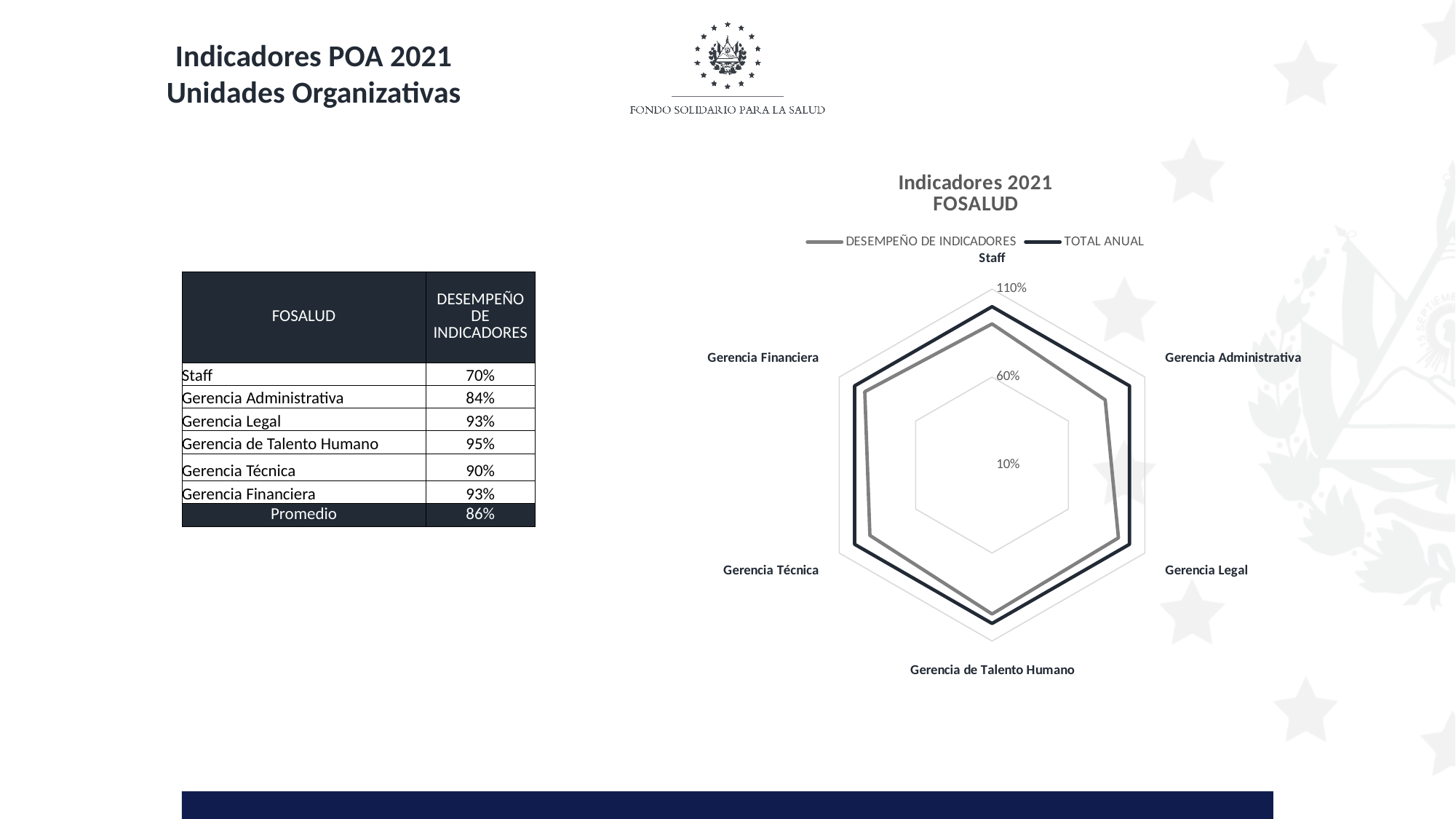
In the 'Indicadores 2021 FOSALUD' chart, is the TOTAL ANUAL value for Gerencia Legal greater or less than 110%? less What kind of chart is the 'Indicadores 2021 FOSALUD' chart? radar chart In the 'Indicadores 2021 FOSALUD' chart, is the DESEMPEÑO DE INDICADORES value for Staff greater or less than 60%? greater Which series in the 'Indicadores 2021 FOSALUD' chart is drawn with the darker line? TOTAL ANUAL In the 'Indicadores 2021 FOSALUD' chart, which series has the larger value for Staff, DESEMPEÑO DE INDICADORES or TOTAL ANUAL? TOTAL ANUAL In the 'Indicadores 2021 FOSALUD' chart, is the DESEMPEÑO DE INDICADORES value for Gerencia Técnica greater or less than 60%? greater What is the highest axis tick shown on the 'Indicadores 2021 FOSALUD' radar chart? 110% How many series does the legend of the 'Indicadores 2021 FOSALUD' chart list? 2 In the 'Indicadores 2021 FOSALUD' chart, which category has the lowest DESEMPEÑO DE INDICADORES value? Gerencia Administrativa What is the title of the radar chart on the slide? Indicadores 2021 FOSALUD How many categories are plotted on the 'Indicadores 2021 FOSALUD' radar chart? 6